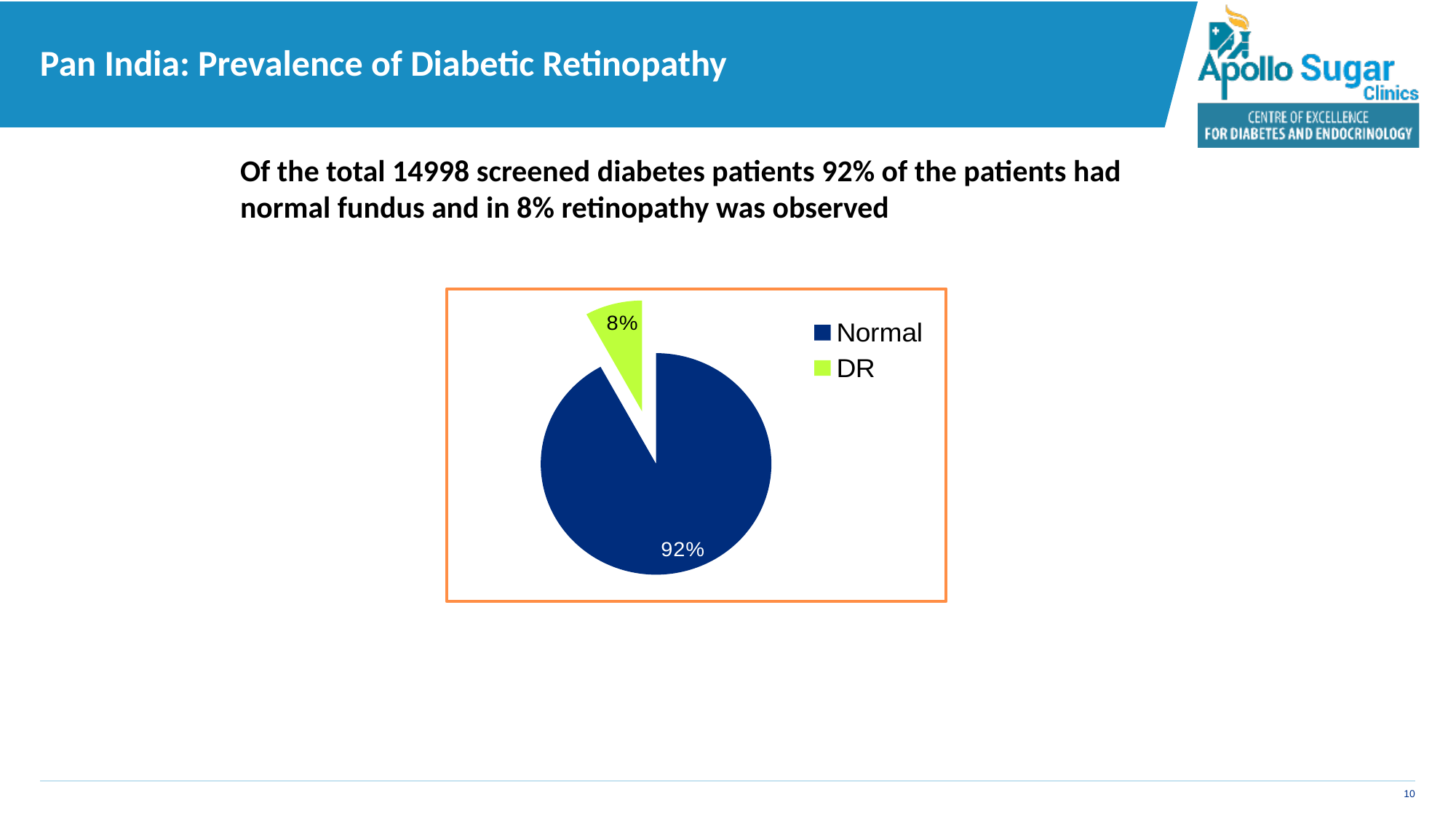
What colour is the DR slice in the pie chart? green What kind of chart is shown on the slide? pie chart Which slice of the pie is the smallest? DR How many entries does the legend list? 2 What is the difference in percentage points between the Normal and DR slices? 84 What share of the pie does the DR slice represent? 8% Which is larger, the Normal slice or the DR slice? Normal What colour is the Normal slice in the pie chart? dark blue Which slice of the pie is the largest? Normal What share of the pie does the Normal slice represent? 92% How many slices does the pie chart have? 2